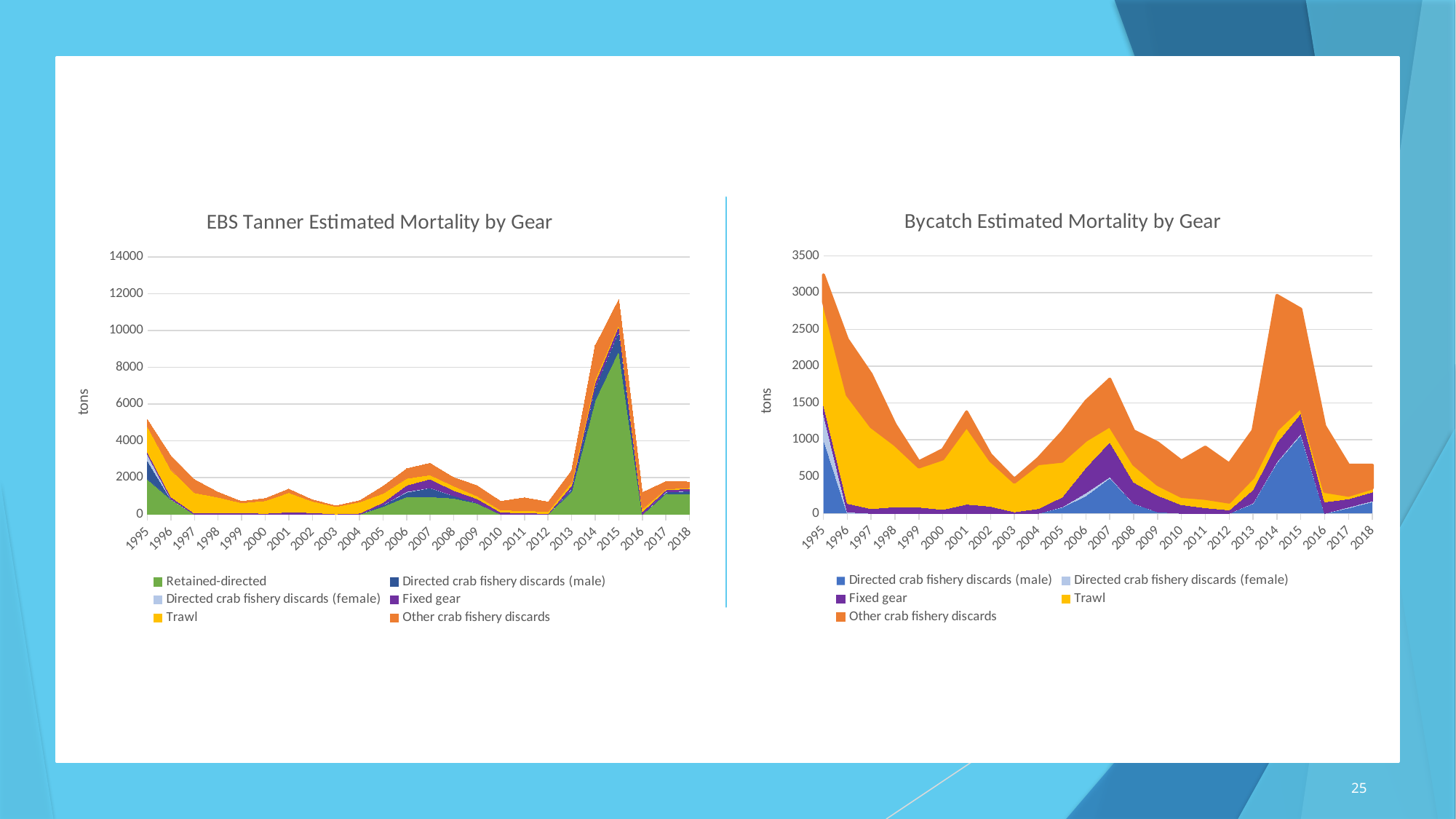
In the Bycatch Estimated Mortality by Gear chart, is the total value for 2003 greater or less than 500? less In the Bycatch Estimated Mortality by Gear chart, is the total value for 2014 greater or less than 2500? greater What is the y-axis label on the Bycatch Estimated Mortality by Gear chart? tons In the Bycatch Estimated Mortality by Gear chart, which year has the highest total mortality? 1995 How many series does the legend of the Bycatch Estimated Mortality by Gear chart list? 5 In the EBS Tanner Estimated Mortality by Gear chart, does the total mortality rise or fall from 2012 to 2015? Rise In the EBS Tanner Estimated Mortality by Gear chart, is the total value for 2003 greater or less than 1000? less How many years are shown on the x axis of the Bycatch Estimated Mortality by Gear chart? 24 In the EBS Tanner Estimated Mortality by Gear chart, which year has the highest total mortality? 2015 How many series does the legend of the EBS Tanner Estimated Mortality by Gear chart list? 6 What kind of chart is the EBS Tanner Estimated Mortality by Gear chart? Stacked area chart